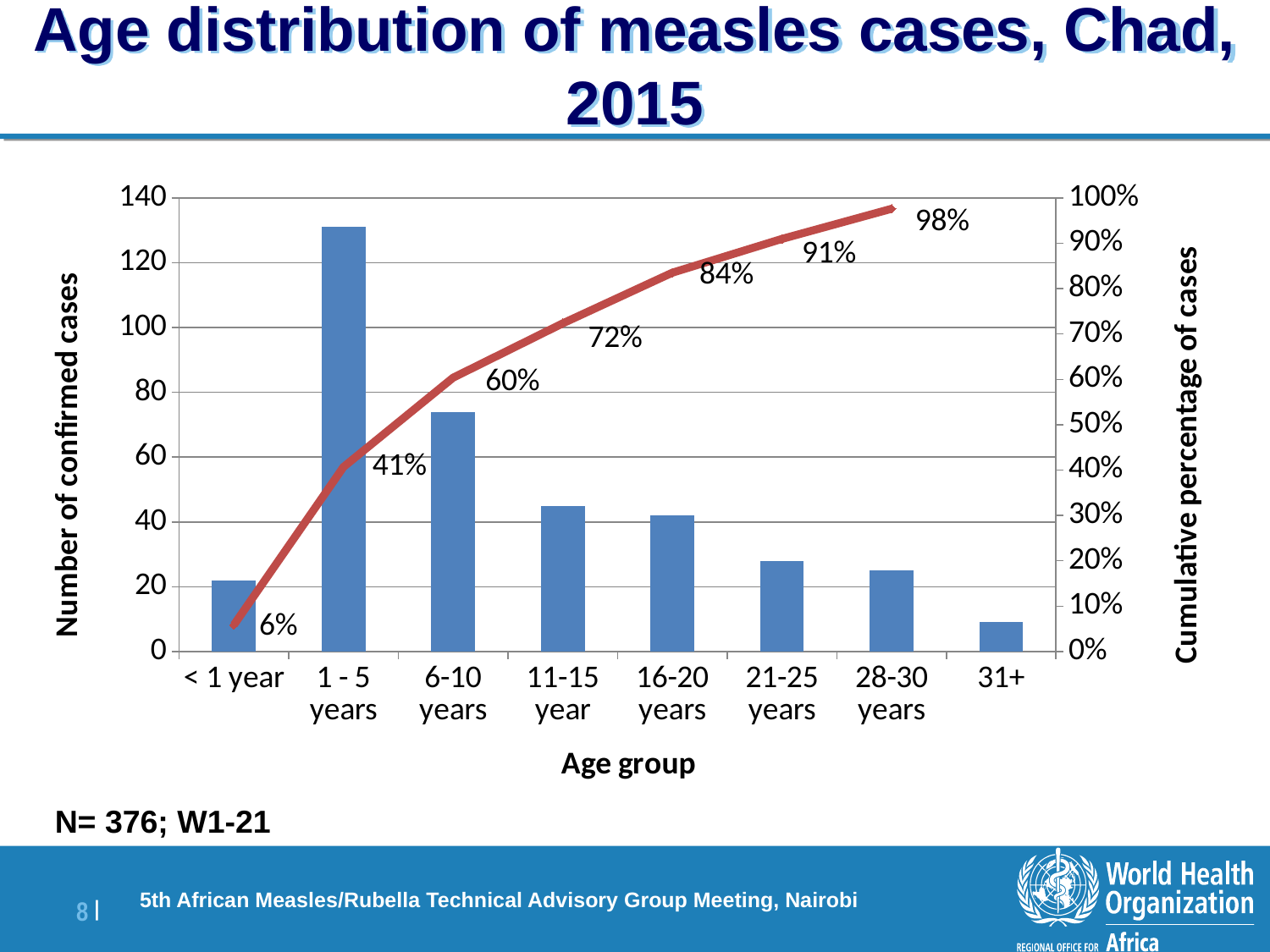
How many age groups are shown on the x axis? 8 Which age group has more confirmed cases, 6-10 years or 11-15 year? 6-10 years Which age group has the lowest number of confirmed measles cases? 31+ What cumulative percentage label is shown at the 16-20 years age group? 84% Is the number of confirmed cases for the 31+ age group greater or less than 20? less Does the cumulative percentage line rise or fall across the age groups from left to right? rise What is the cumulative percentage of cases shown for the < 1 year age group? 6% Which age group has the highest number of confirmed measles cases? 1 - 5 years Is the number of confirmed cases for the 1 - 5 years age group greater or less than 120? greater By how many percentage points does the cumulative percentage rise from the < 1 year group to the 1 - 5 years group? 35 percentage points What is the cumulative percentage of cases shown for the 1 - 5 years age group? 41% Is the number of confirmed cases for the 6-10 years age group greater or less than 80? less